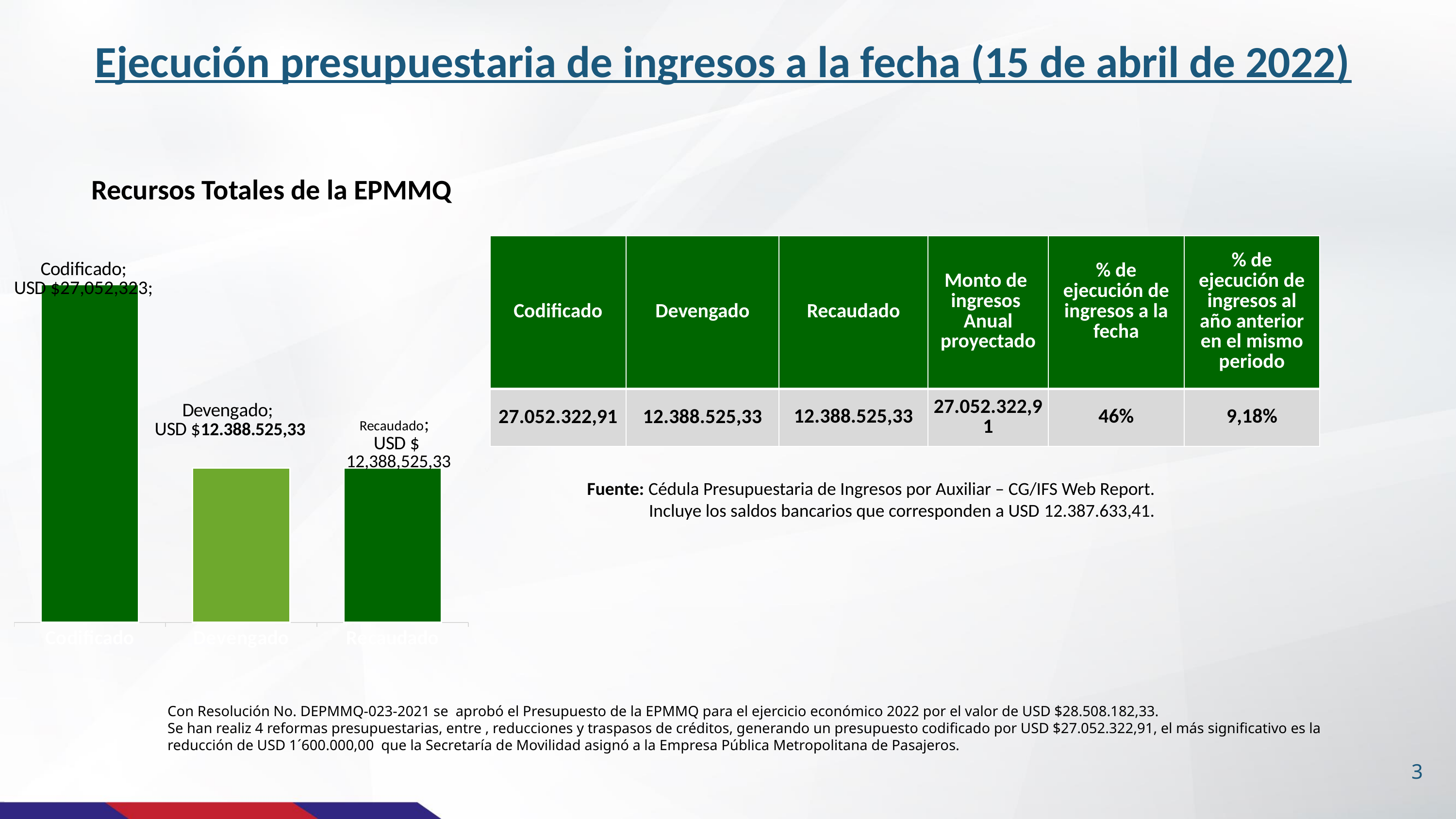
In the 'Recursos Totales de la EPMMQ' chart, which is larger, Codificado or Devengado? Codificado In the 'Recursos Totales de la EPMMQ' chart, which is larger, Codificado or Recaudado? Codificado In the 'Recursos Totales de la EPMMQ' chart, does the value rise or fall from Codificado to Devengado? fall In the 'Recursos Totales de la EPMMQ' chart, what value is labelled for Devengado? USD $12.388.525,33 What is the title of the bar chart on the slide? Recursos Totales de la EPMMQ How many bars are plotted in the 'Recursos Totales de la EPMMQ' chart? 3 In the 'Recursos Totales de la EPMMQ' chart, which bar is drawn in a lighter green than the other two? Devengado What kind of chart is shown under the heading 'Recursos Totales de la EPMMQ'? bar chart In the 'Recursos Totales de la EPMMQ' chart, what value is labelled for Recaudado? USD $ 12,388,525,33 Which category has the tallest bar in the 'Recursos Totales de la EPMMQ' chart? Codificado In the 'Recursos Totales de la EPMMQ' chart, what value is labelled for Codificado? USD $27,052,323